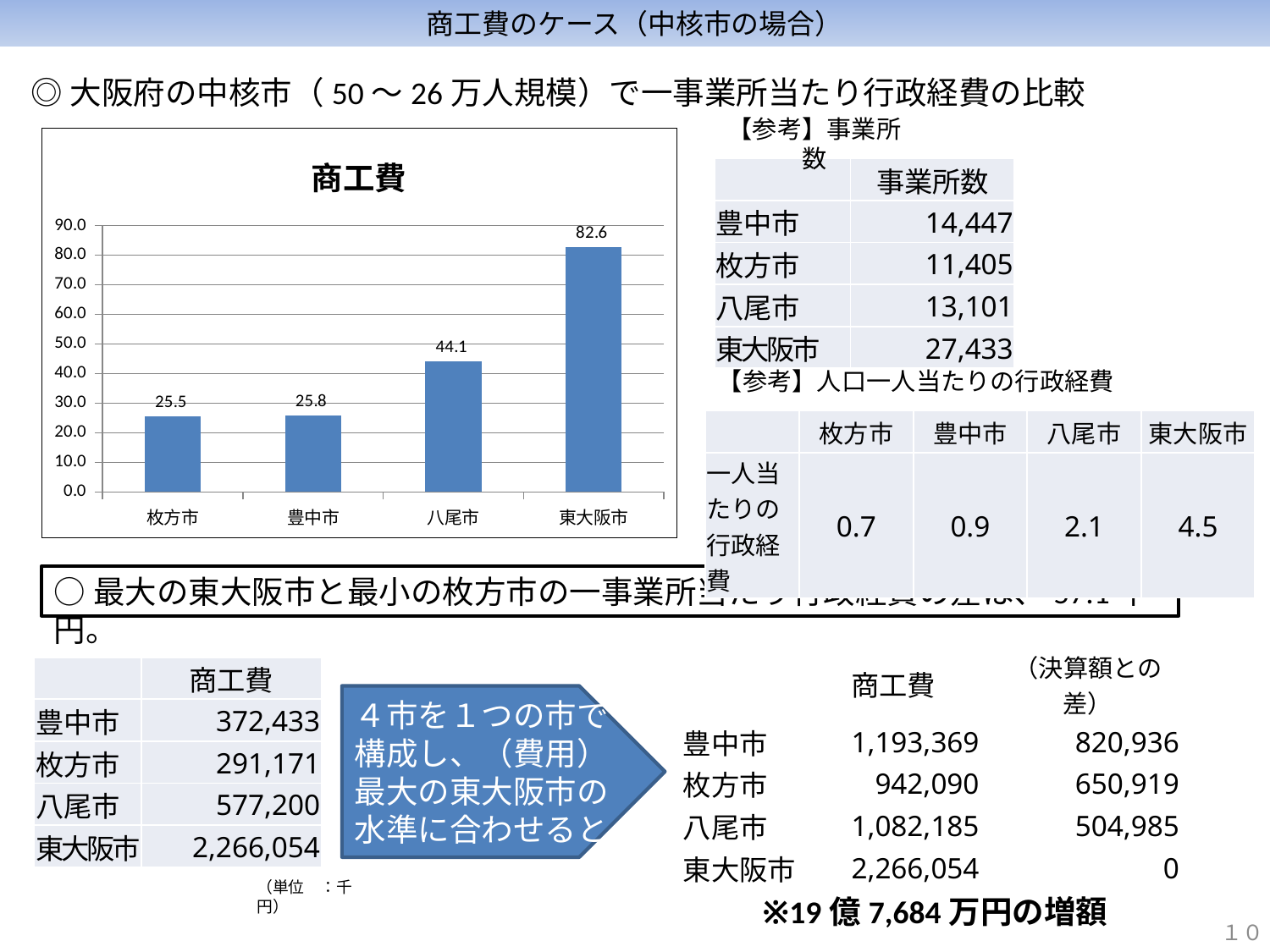
What is the value for 枚方市 in the 商工費 chart? 25.5 What is the value for 豊中市 in the 商工費 chart? 25.8 What is the value for 東大阪市 in the 商工費 chart? 82.6 What is the difference between the values for 東大阪市 and 枚方市 in the 商工費 chart? 57.1 What is the value for 八尾市 in the 商工費 chart? 44.1 Is the value for 東大阪市 in the 商工費 chart greater or less than 80.0? greater What is the difference between the values for 八尾市 and 豊中市 in the 商工費 chart? 18.3 In the 商工費 chart, which is larger, the value for 八尾市 or the value for 豊中市? 八尾市 Which city has the highest value in the 商工費 chart? 東大阪市 How many cities are shown in the 商工費 chart? 4 Which city has the lowest value in the 商工費 chart? 枚方市 What kind of chart is the 商工費 chart? bar chart